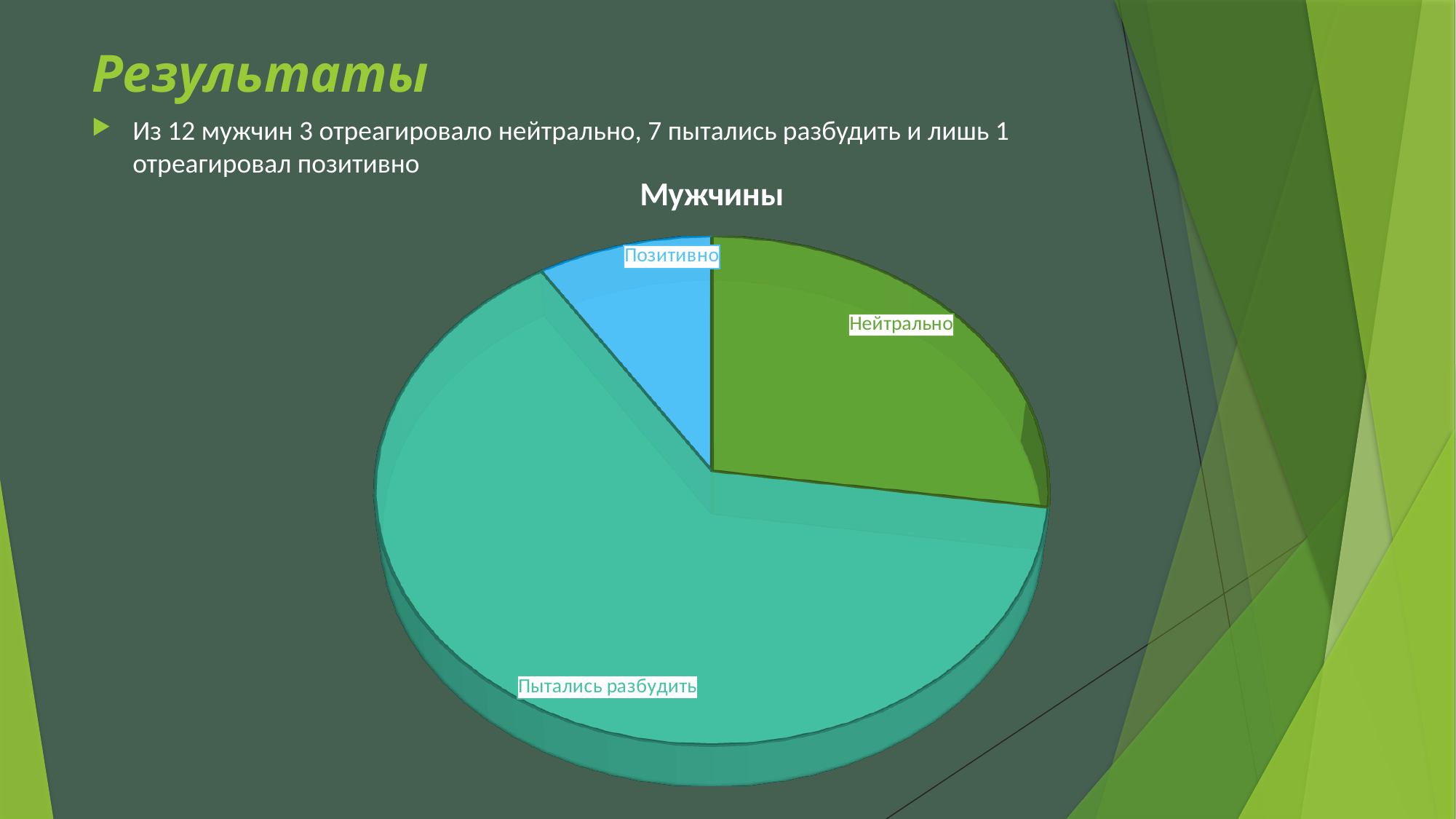
According to the slide, how many men tried to wake (Пытались разбудить)? 7 Which slice of the pie chart is the smallest? Позитивно What is the title of the pie chart? Мужчины According to the slide, how many men reacted positively (Позитивно)? 1 How many slices does the pie chart have? 3 What colour is the Позитивно slice in the pie chart? Blue What kind of chart is shown on the slide? Pie chart Which slice is larger, Пытались разбудить or Нейтрально? Пытались разбудить Which slice is larger, Нейтрально or Позитивно? Нейтрально Which slice of the pie chart is the largest? Пытались разбудить How many more men tried to wake (Пытались разбудить) than reacted neutrally (Нейтрально)? 4 According to the slide, how many men reacted neutrally (Нейтрально)? 3